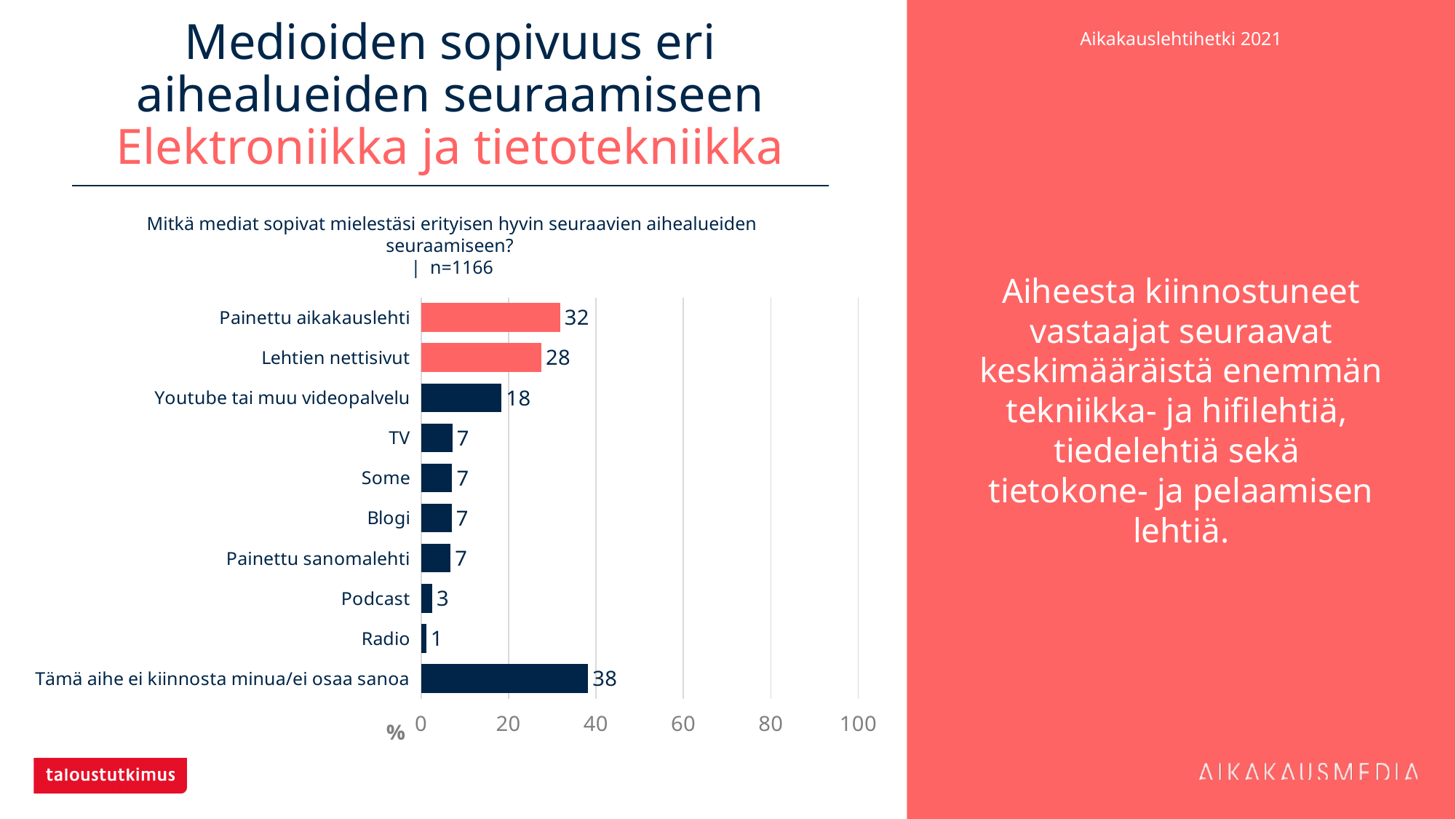
What is the value for Podcast? 3 What kind of chart is shown on the slide? bar chart Which category has the highest value? Tämä aihe ei kiinnosta minua/ei osaa sanoa What is the value for Lehtien nettisivut? 28 Is the value for Tämä aihe ei kiinnosta minua/ei osaa sanoa greater or less than 20? greater What is the difference between the values for Painettu aikakauslehti and Lehtien nettisivut? 4 What is the value for Youtube tai muu videopalvelu? 18 What is the sample size (n) stated above the chart? n=1166 What is the value for Painettu aikakauslehti? 32 Which is larger, the value for Youtube tai muu videopalvelu or the value for TV? Youtube tai muu videopalvelu Which category has the lowest value? Radio How many categories are shown in the chart? 10